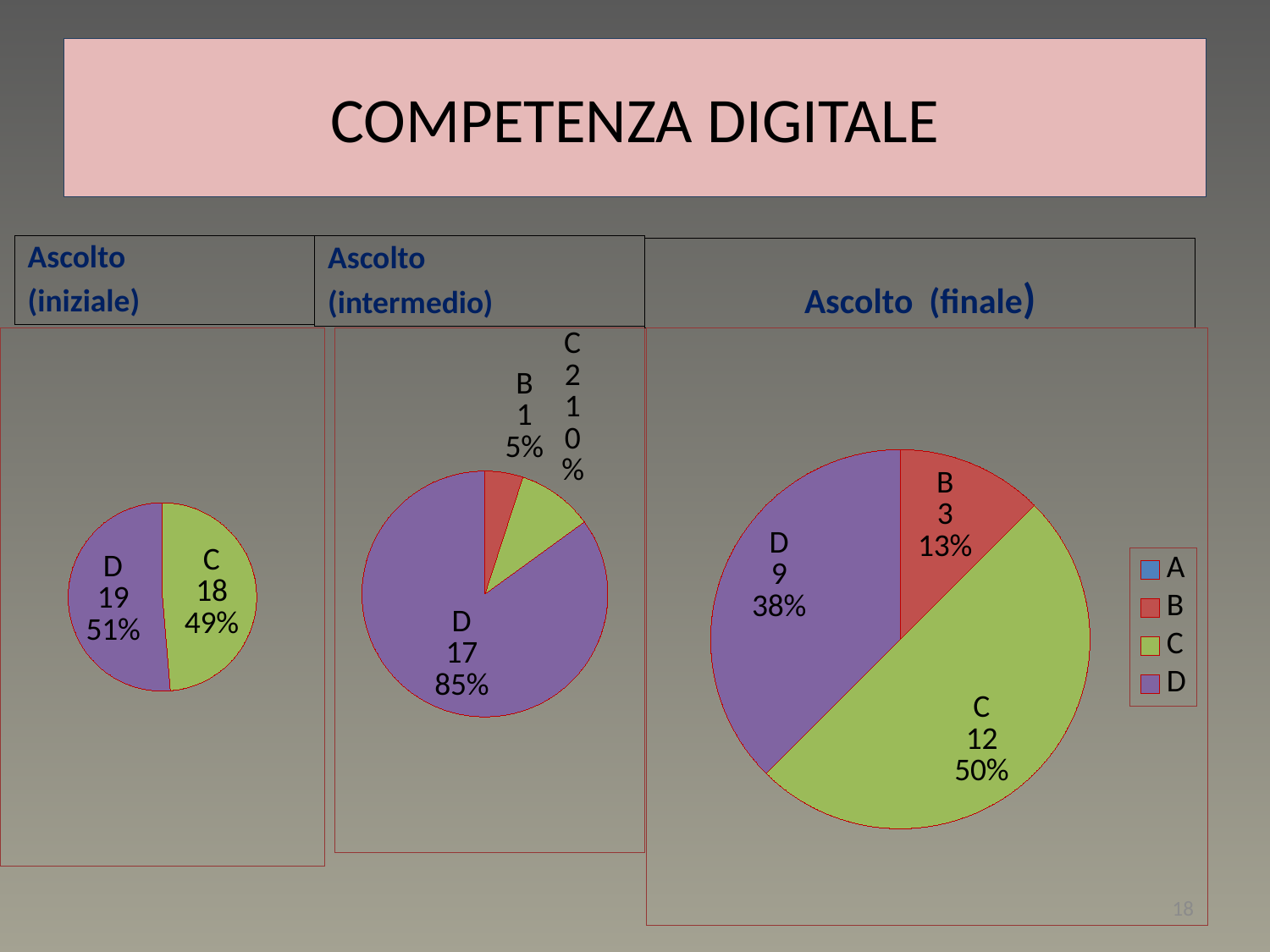
In the Ascolto (intermedio) chart, what share of the pie does category B have? 5% In the Ascolto (iniziale) chart, what value is shown for category D? 19 In the Ascolto (finale) chart, which category has the largest slice? C What kind of chart is the Ascolto (iniziale) chart? Pie chart In the Ascolto (finale) chart, what is the difference between the values for C and D? 3 In the Ascolto (finale) chart, what value is shown for category C? 12 In the Ascolto (finale) chart, what share of the pie does category D have? 38% In the Ascolto (intermedio) chart, which category has the smallest slice? B In the Ascolto (finale) chart, which is larger, the value for B or the value for D? D How many entries does the legend of the Ascolto (finale) chart list? 4 In the Ascolto (intermedio) chart, what value is shown for category D? 17 In the Ascolto (iniziale) chart, what share of the pie does category C have? 49%